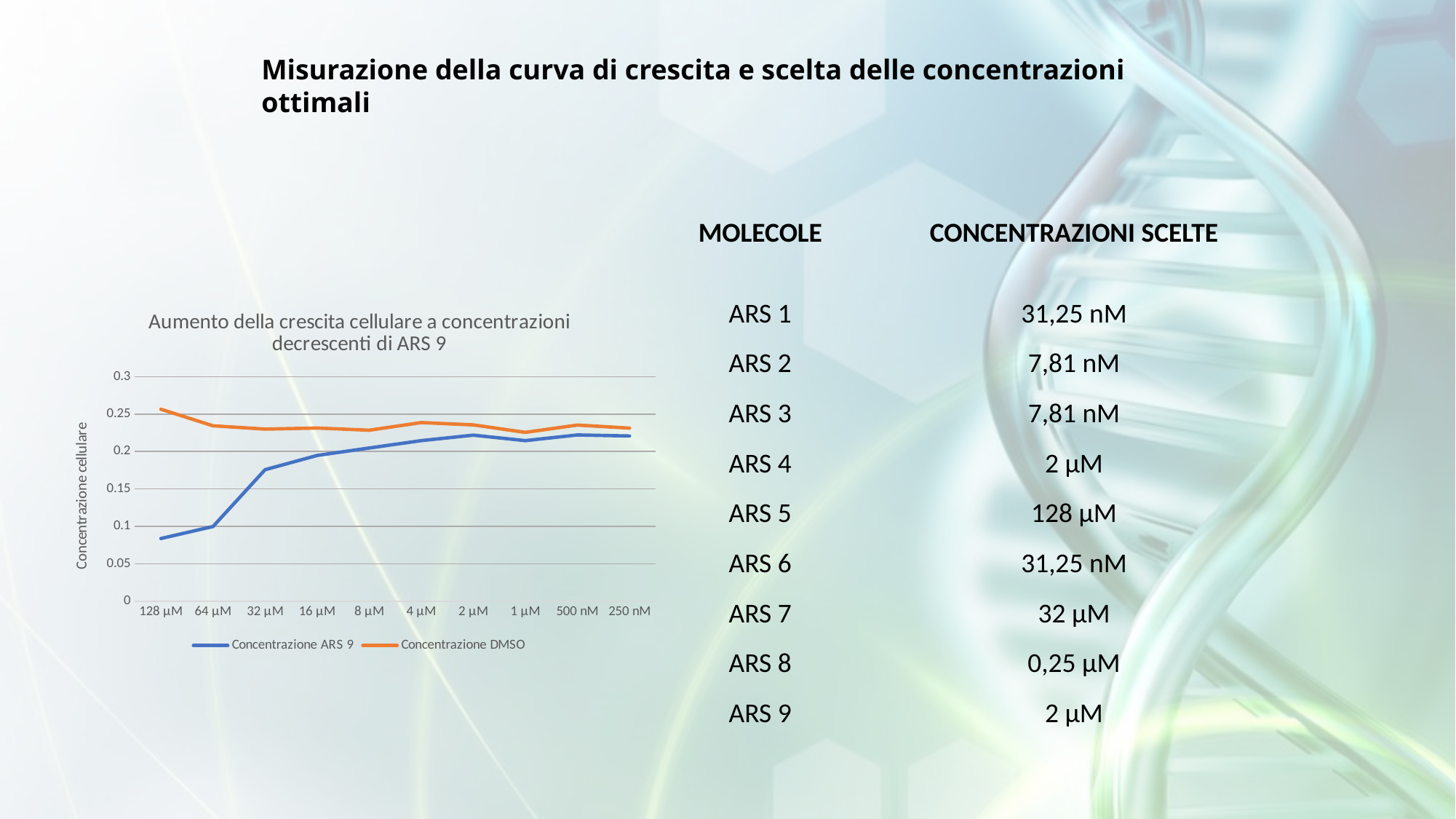
What is the label of the chart's y axis? Concentrazione cellulare What is the title of the chart? Aumento della crescita cellulare a concentrazioni decrescenti di ARS 9 Is the value for Concentrazione ARS 9 at 32 µM greater or less than 0.15? greater How many series does the chart legend list? 2 What kind of chart is shown on the slide? Line chart Does the Concentrazione ARS 9 line rise or fall as you move from 128 µM to 250 nM along the x axis? Rise How many concentration points are plotted along the x axis of the chart? 10 At which x-axis concentration is the Concentrazione ARS 9 line at its lowest? 128 µM Is the value for Concentrazione ARS 9 at 128 µM greater or less than 0.1? less Is the value for Concentrazione DMSO at 128 µM greater or less than 0.25? greater At 128 µM, which series has the larger value, Concentrazione ARS 9 or Concentrazione DMSO? Concentrazione DMSO